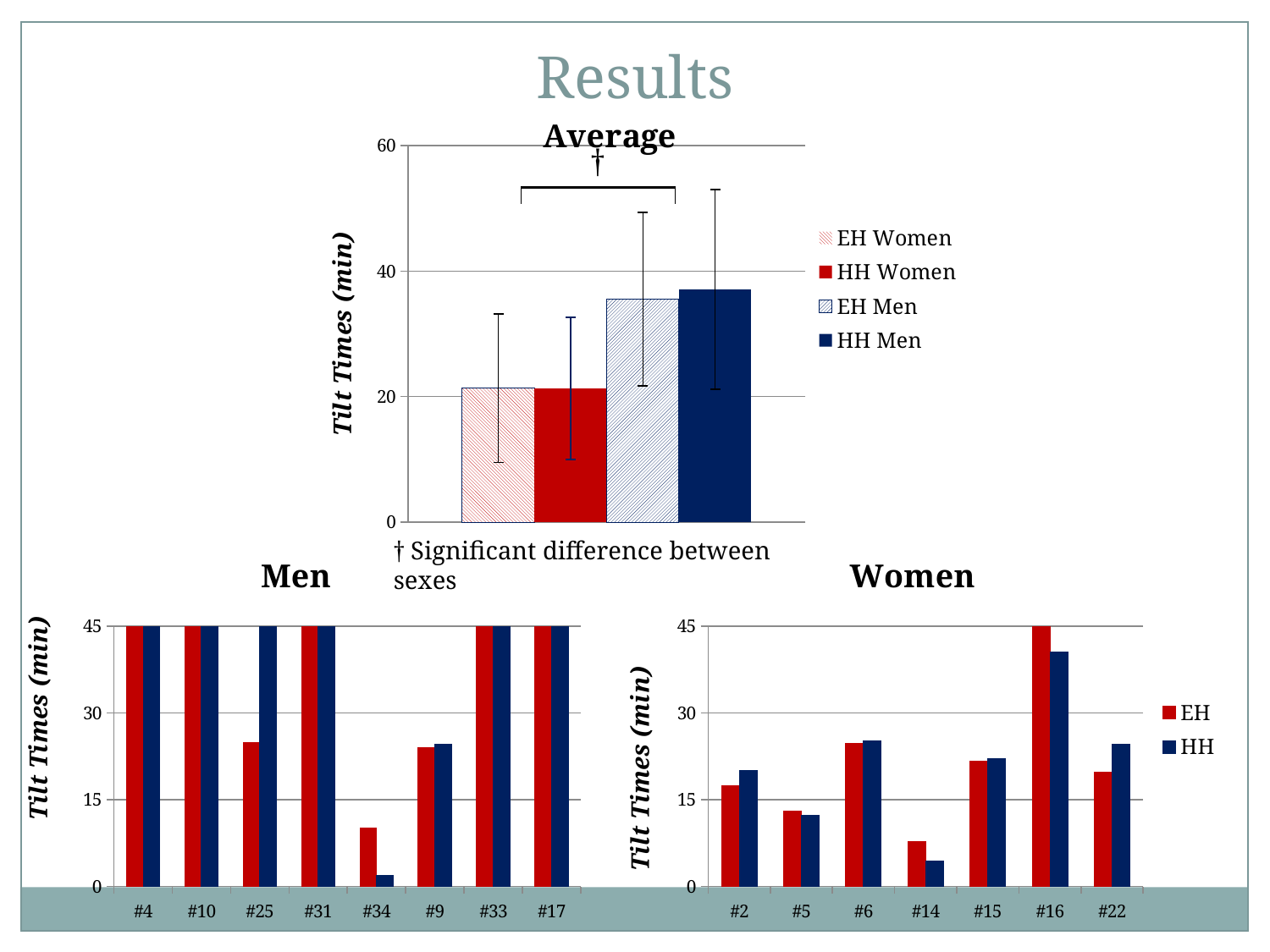
How many participants are shown on the x axis of the Men chart? 8 In the Average chart, is the value for HH Men greater or less than 20? greater In the Men chart, what is the EH value for #4? 45 How many series does the legend of the Average chart list? 4 In the Men chart, which participant has the lowest HH value? #34 In the Women chart, which participant has the highest EH value? #16 In the Average chart, which is larger, EH Men or HH Women? EH Men How many series does the legend of the Women chart list? 2 How many participants are shown on the x axis of the Women chart? 7 In the Women chart, is the HH value for #14 greater or less than 15? less In the Women chart, what is the EH value for #16? 45 What kind of chart is the Average chart? bar chart